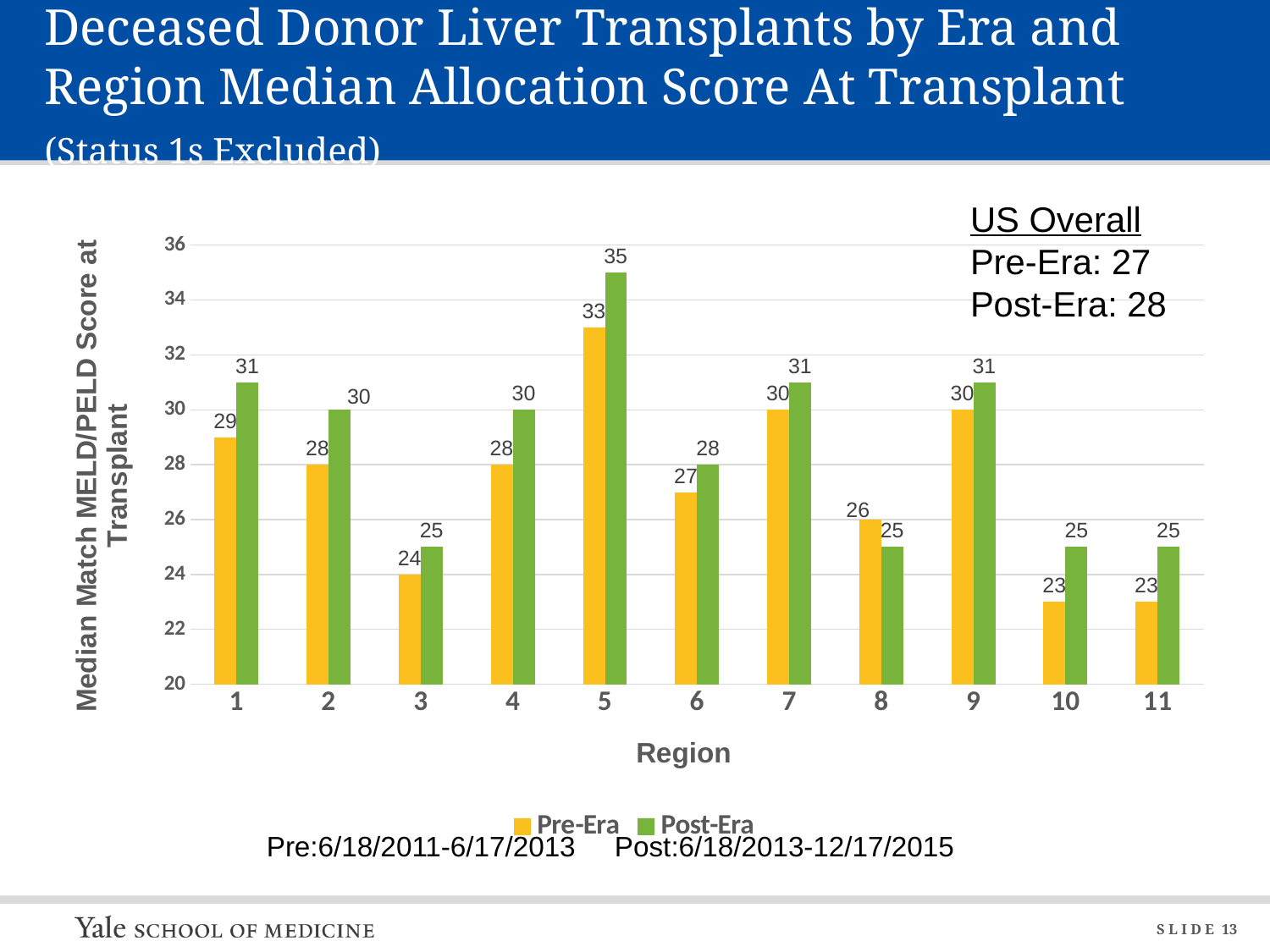
How many series does the legend list? 2 Which regions have the lowest Pre-Era median match MELD/PELD score? 10 and 11 Which region has the highest Post-Era median match MELD/PELD score? 5 Is the Post-Era value for Region 5 greater or less than 34? greater How many regions are shown on the x axis? 11 What is the Post-Era median match MELD/PELD score for Region 3? 25 What is the US Overall Post-Era median allocation score shown on the slide? 28 What kind of chart is shown on the slide? Bar chart What is the Pre-Era median match MELD/PELD score for Region 5? 33 What colour represents the Post-Era series in the chart? Green Which is larger for Region 8, the Pre-Era or the Post-Era median score? Pre-Era What is the difference between the Post-Era and Pre-Era median scores for Region 3? 1